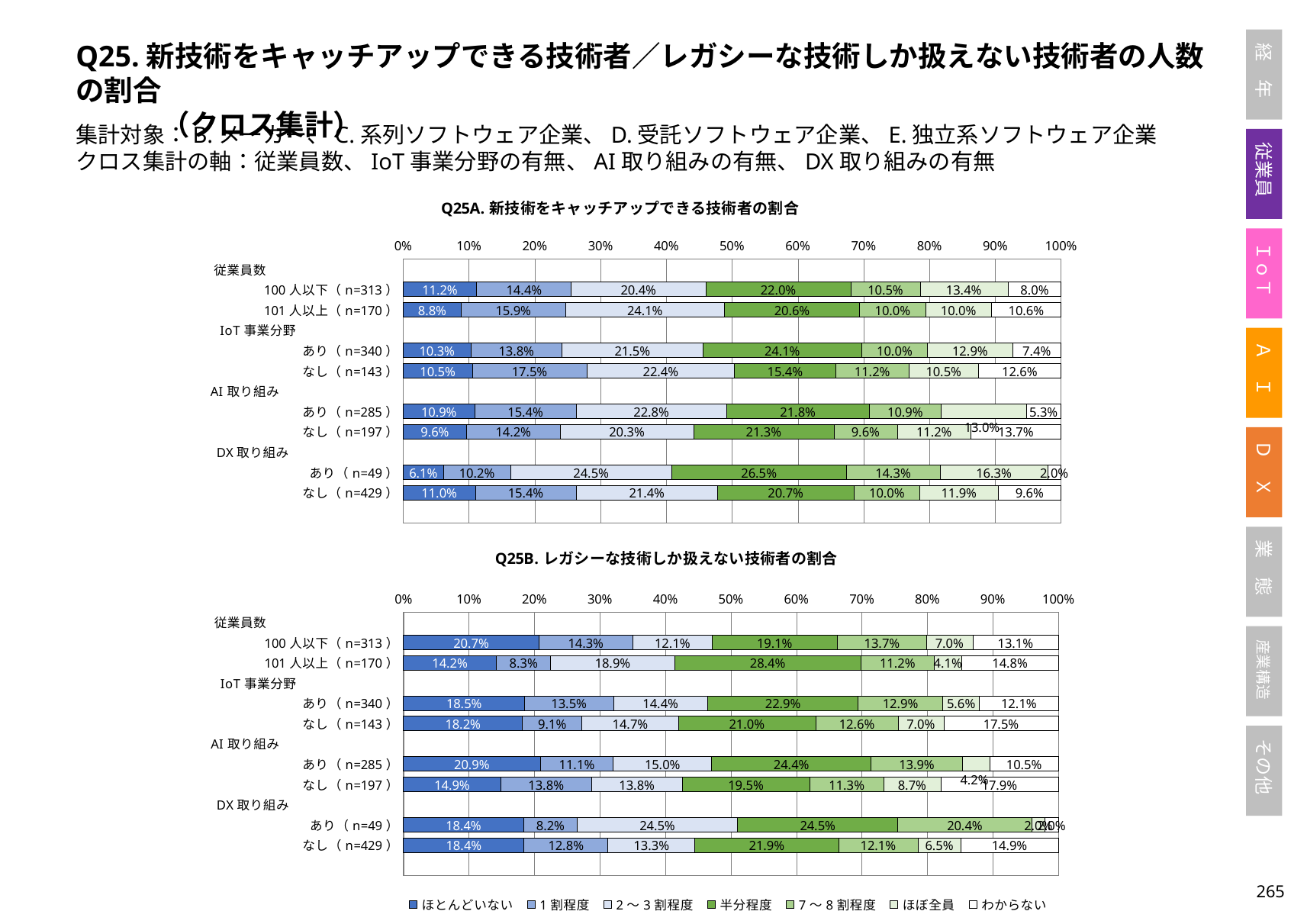
In the Q25B chart, what is the value of the わからない segment for AI取り組み なし (n=197)? 17.9% How many series does the legend at the bottom of the slide list? 7 In the Q25A chart, what is the difference between the 2～3割程度 values for 101人以上 (n=170) and 100人以下 (n=313)? 3.7% What is the title of the upper chart on the slide? Q25A. 新技術をキャッチアップできる技術者の割合 In the Q25A chart (新技術をキャッチアップできる技術者の割合), what is the value of the ほとんどいない segment for 100人以下 (n=313)? 11.2% What type of chart is used for Q25B? Stacked bar chart In the Q25B chart (レガシーな技術しか扱えない技術者の割合), what is the value of the 半分程度 segment for 101人以上 (n=170)? 28.4% In the Q25B chart, which is larger: the ほとんどいない value for IoT事業分野 あり (n=340) or for IoT事業分野 なし (n=143)? IoT事業分野 あり (n=340) In the Q25A chart, what is the value of the 半分程度 segment for DX取り組み あり (n=49)? 26.5% In the Q25B chart, which row has the lowest value for the ほとんどいない segment? 101人以上 (n=170) In the Q25A chart, which row has the highest value for the 半分程度 segment? DX取り組み あり (n=49) How many bars (rows with data) are plotted in the Q25A chart? 8